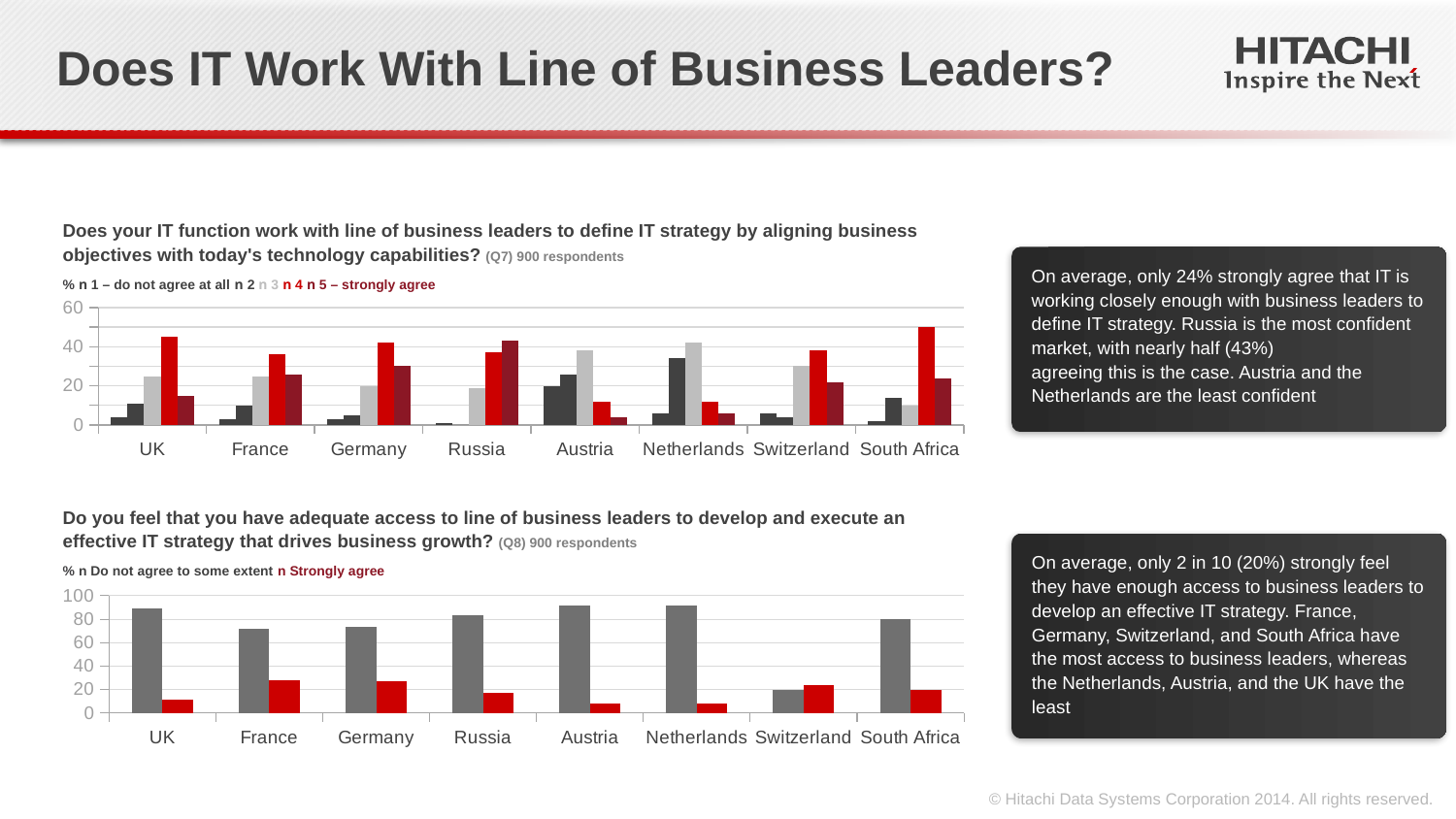
In the bottom chart (Q8), is the 'Do not agree to some extent' value for Switzerland greater or less than 40? less How many series does the legend of the top chart (Q7) list? 5 How many series does the legend of the bottom chart (Q8) list? 2 In the top chart (Q7), which country has the highest value for the '2' series? Netherlands In the top chart (Q7), is the '5 – strongly agree' value for the Netherlands greater or less than 20? less In the top chart (Q7), which is larger: the '5 – strongly agree' value for the UK or for the Netherlands? UK What kind of chart is the top chart (Q7) on the slide? bar chart In the bottom chart (Q8), what colour are the 'Strongly agree' bars? red In the bottom chart (Q8), is the 'Do not agree to some extent' value for the UK greater or less than 80? greater How many countries are shown on the x axis of the top chart (Q7)? 8 In the bottom chart (Q8), which is larger: the 'Strongly agree' value for France or for the UK? France